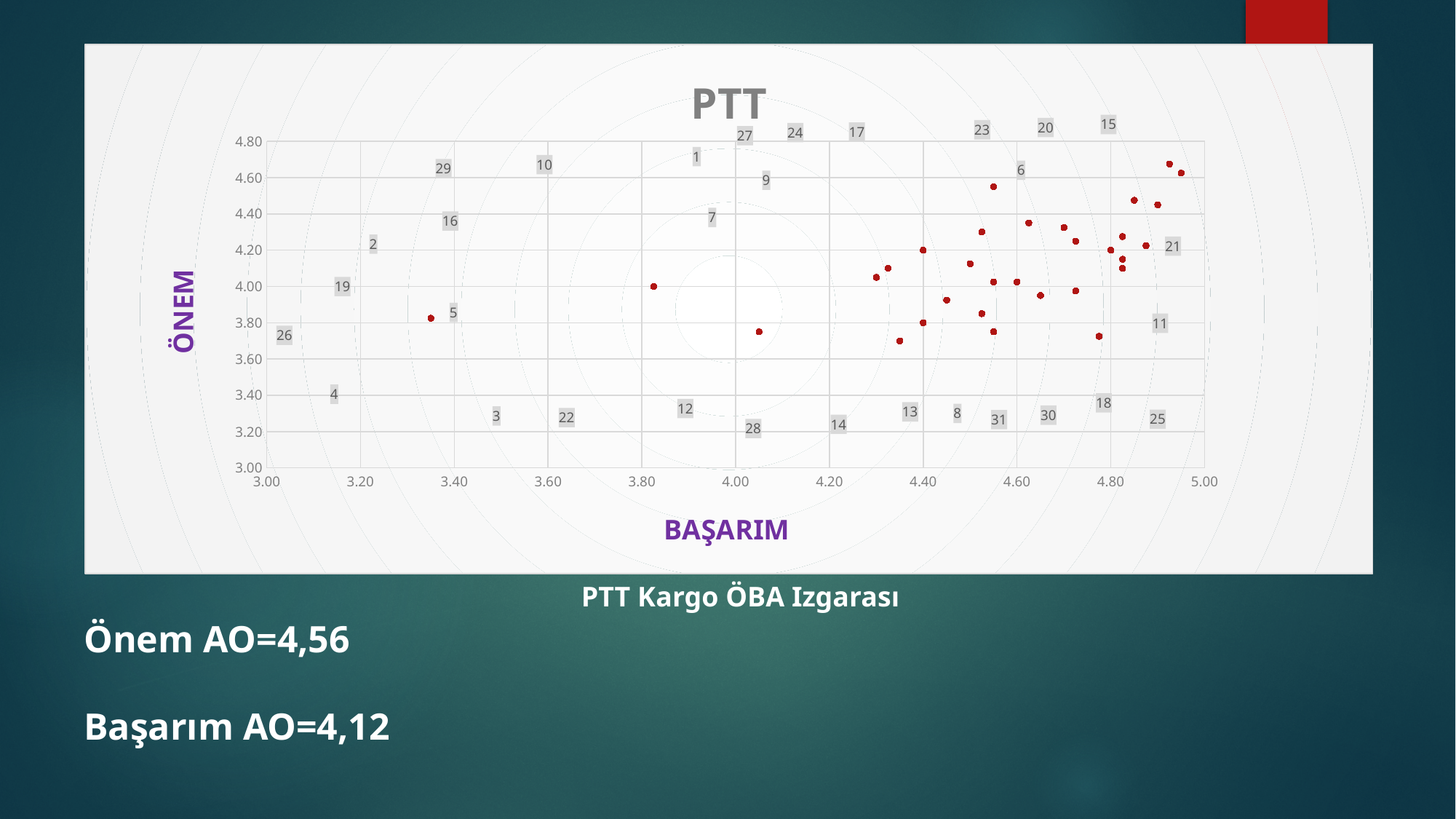
How many numbered data labels are shown on the chart? 31 What is the title of the chart? PTT Is the BAŞARIM value of the rightmost point greater or less than 4.80? greater Is the BAŞARIM value of the leftmost point greater or less than 3.40? less What are the x-axis and y-axis titles of the chart? BAŞARIM (x-axis) and ÖNEM (y-axis) What kind of chart is shown on the slide? scatter chart Is the BAŞARIM value of the lowest point (the one with the smallest ÖNEM) greater or less than 4.20? greater